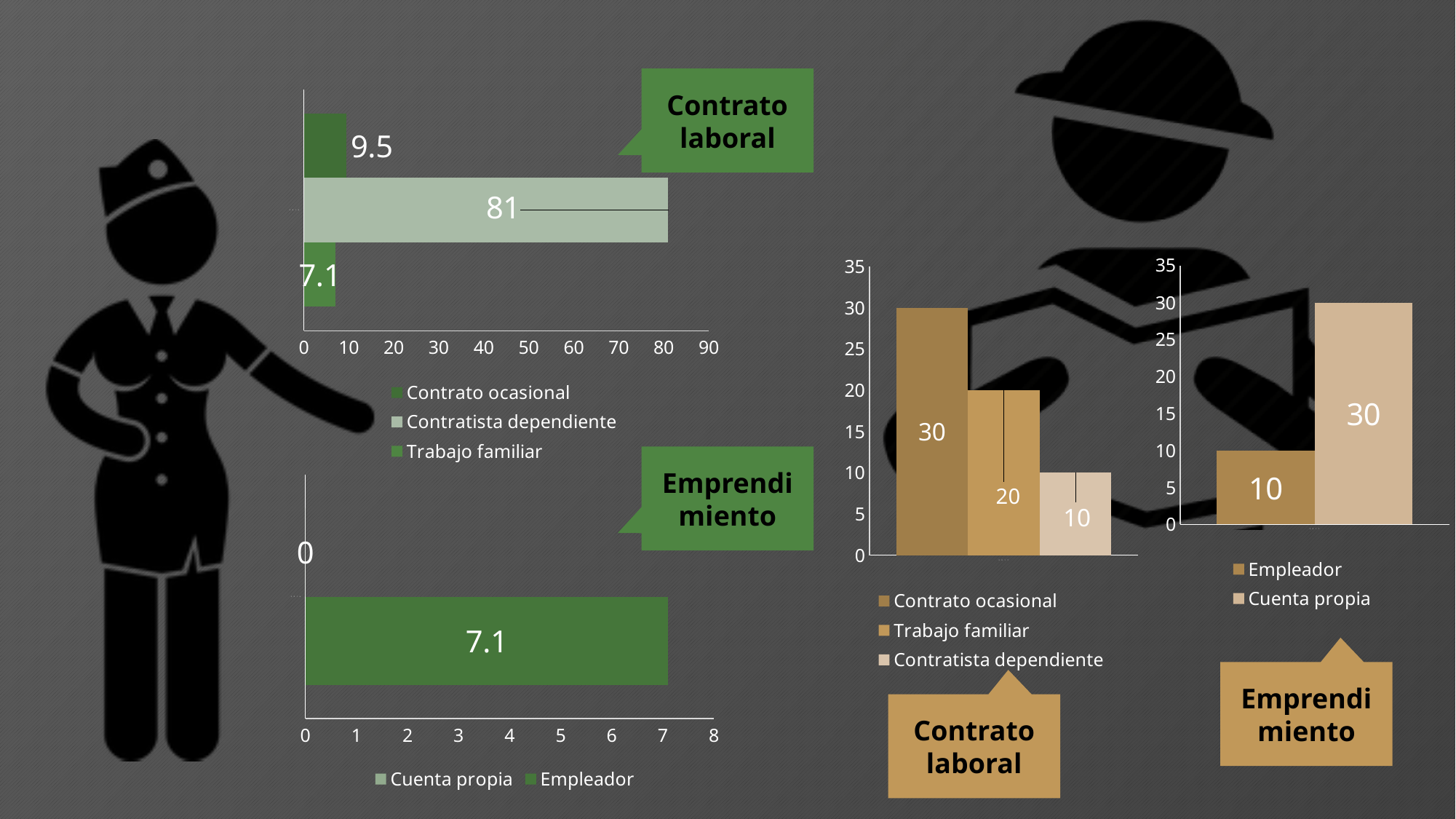
In the green 'Emprendimiento' bar chart at the bottom left, what is the value for Cuenta propia? 0 What type of chart is the green 'Emprendimiento' chart at the bottom left? Bar chart In the brown 'Contrato laboral' bar chart on the right, what is the value for Trabajo familiar? 20 In the brown 'Emprendimiento' bar chart at the far right, which is larger, Empleador or Cuenta propia? Cuenta propia In the green 'Contrato laboral' bar chart at the top left, what is the difference between Contratista dependiente and Contrato ocasional? 71.5 In the green 'Emprendimiento' bar chart at the bottom left, what is the value for Empleador? 7.1 In the brown 'Emprendimiento' bar chart at the far right, what is the difference between Cuenta propia and Empleador? 20 How many series does the legend of the green 'Contrato laboral' chart at the top left list? 3 In the green 'Contrato laboral' bar chart at the top left, what is the value for Contratista dependiente? 81 In the green 'Contrato laboral' bar chart at the top left, which category has the highest value? Contratista dependiente In the green 'Contrato laboral' bar chart at the top left, what is the value for Contrato ocasional? 9.5 In the brown 'Contrato laboral' bar chart on the right, which category has the lowest value? Contratista dependiente